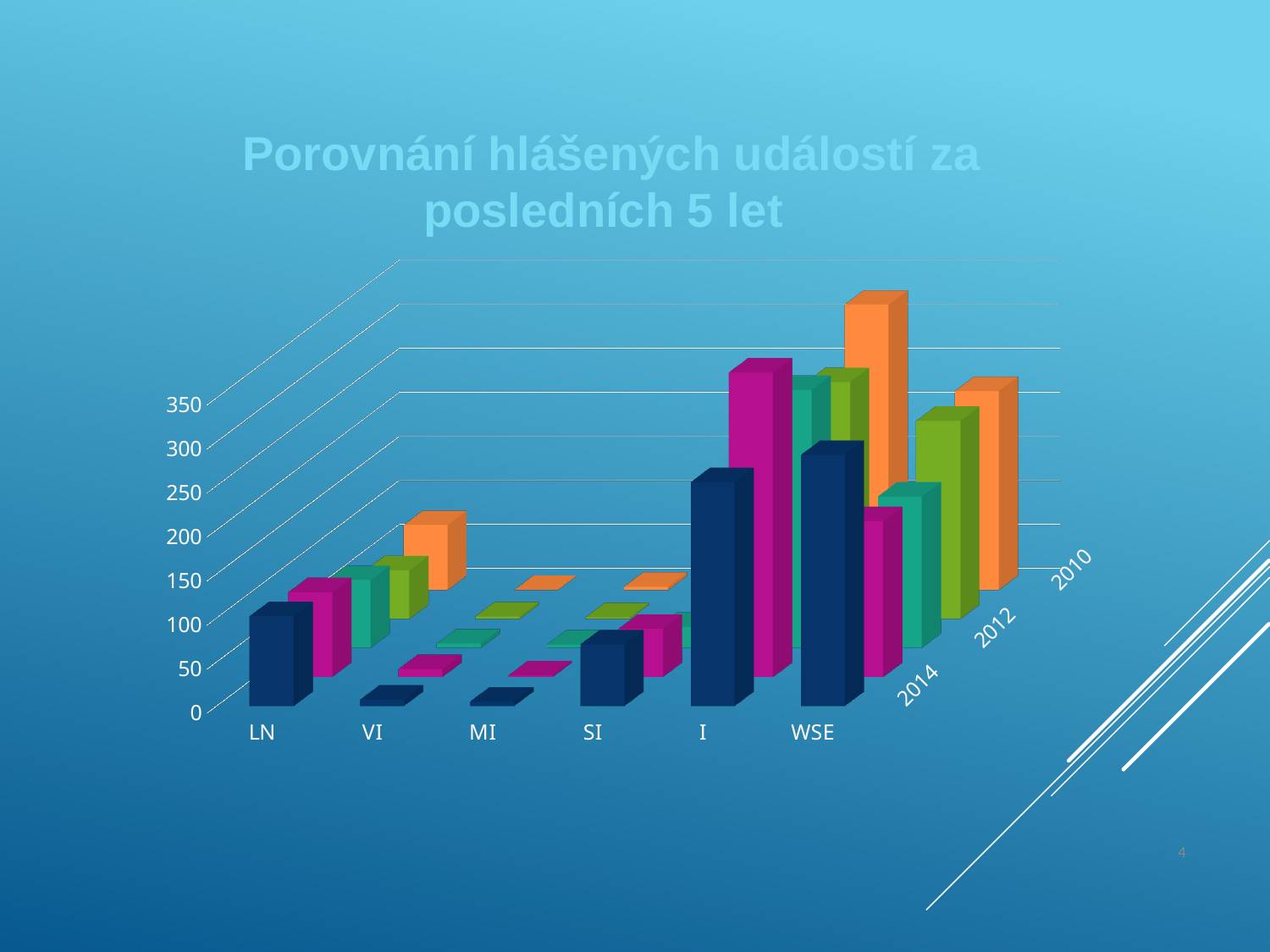
What kind of chart is shown on the slide? bar chart Is the 2014 value for WSE greater or less than 200? greater How many categories are shown along the horizontal axis of the chart? 6 In 2014, which has the larger value, WSE or LN? WSE Is the 2014 value for I greater or less than 200? greater Is the 2014 value for VI greater or less than 50? less What is the title of the chart? Porovnání hlášených událostí za posledních 5 let In 2014, which has the larger value, I or MI? I Which years are labeled on the depth axis of the chart? 2014, 2012, 2010